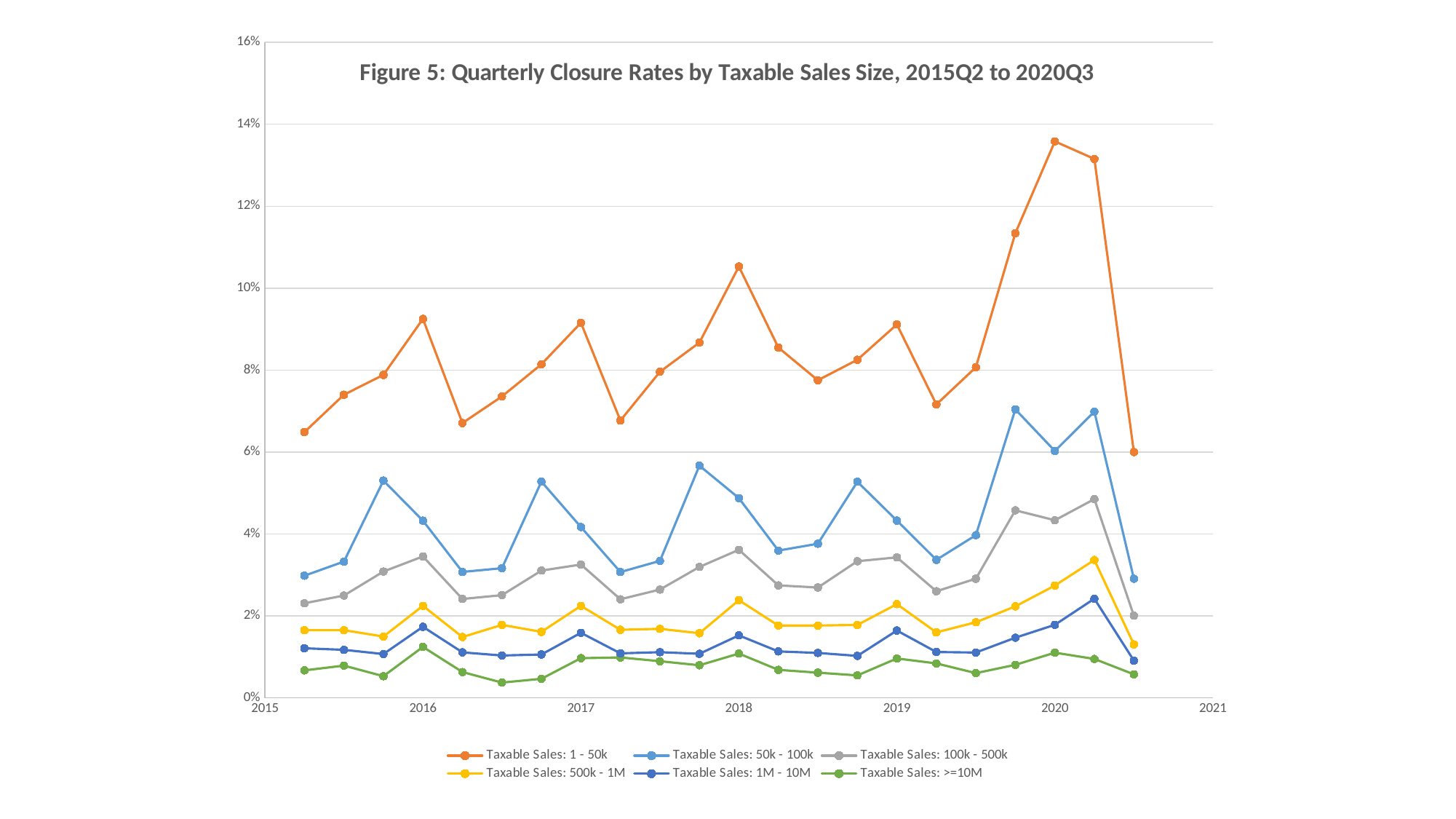
What is the title of the chart? Figure 5: Quarterly Closure Rates by Taxable Sales Size, 2015Q2 to 2020Q3 Which series has the highest closure rates throughout the chart? Taxable Sales: 1 - 50k How many quarterly data points does each series have? 22 Is the value for Taxable Sales: 1 - 50k at 2020 greater or less than 12%? greater How many series does the legend list? 6 Which series is drawn in green? Taxable Sales: >=10M At 2020, which is larger: the value for Taxable Sales: 1 - 50k or Taxable Sales: 50k - 100k? Taxable Sales: 1 - 50k Which series has the lowest closure rates throughout the chart? Taxable Sales: >=10M What kind of chart is shown on the slide? line chart Does the Taxable Sales: 1 - 50k series rise or fall between 2020Q2 and 2020Q3? fall Is the value for Taxable Sales: 50k - 100k at the last point (2020Q3) greater or less than 4%? less Is the value for Taxable Sales: >=10M at 2018 greater or less than 2%? less